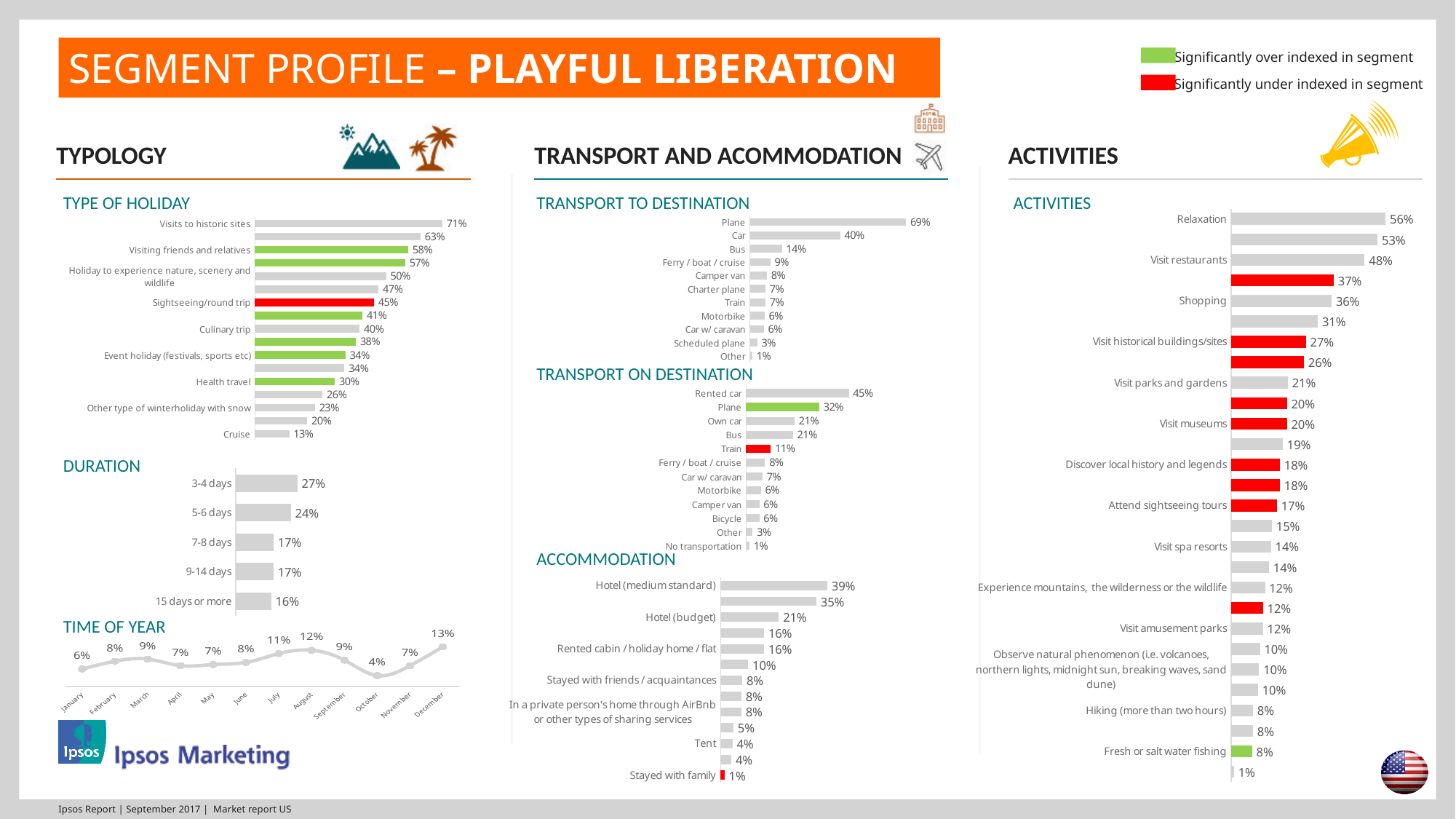
What kind of chart is the Time of Year chart? Line chart In the Time of Year chart, what is the value for October? 4% In the Transport on Destination chart, which is larger, Plane or Own car? Plane In the Activities chart, what is the value for Shopping? 36% In the Type of Holiday chart, which labelled category has the lowest value? Cruise In the Transport to Destination chart, what is the value for Car? 40% In the Time of Year chart, which month has the highest value? December In the Duration chart, what is the difference between 3-4 days and 15 days or more? 11% In the Accommodation chart, what is the value for Hotel (medium standard)? 39% In the Duration chart, what is the value for 5-6 days? 24% In the Activities chart, what is the difference between Relaxation and Visit restaurants? 8% In the Type of Holiday chart, what is the value for Visits to historic sites? 71%